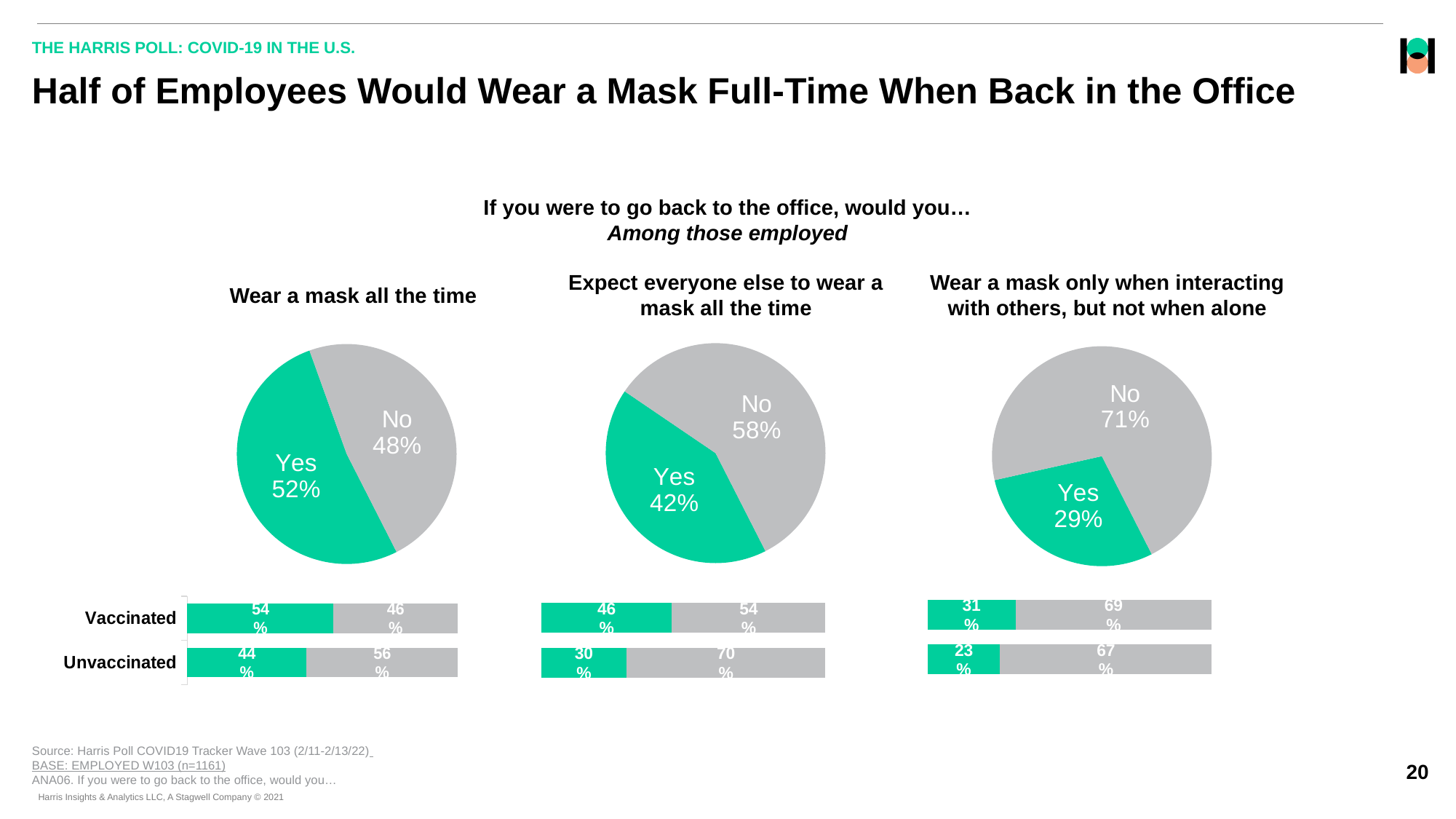
In the 'Wear a mask all the time' pie chart, is the Yes slice larger or smaller than the No slice? larger How many pie charts are shown on the slide? 3 In the 'Expect everyone else to wear a mask all the time' pie chart, what share answered No? 58% Which of the three pie charts has the largest Yes share? Wear a mask all the time Which of the three pie charts has the smallest Yes share? Wear a mask only when interacting with others, but not when alone In the bar chart under 'Wear a mask all the time', what is the Yes value for Vaccinated employees? 54% What kind of chart is used to show the overall Yes/No split for each question? pie chart In the 'Wear a mask only when interacting with others, but not when alone' pie chart, what share answered Yes? 29% In the bar chart under 'Expect everyone else to wear a mask all the time', what is the Yes value for Unvaccinated employees? 30% In the bar chart under 'Wear a mask only when interacting with others, but not when alone', which group has the higher Yes value, Vaccinated or Unvaccinated? Vaccinated In the 'Wear a mask all the time' pie chart, what share of employees answered Yes? 52% In the 'Expect everyone else to wear a mask all the time' pie chart, what is the difference between the No and Yes shares? 16%